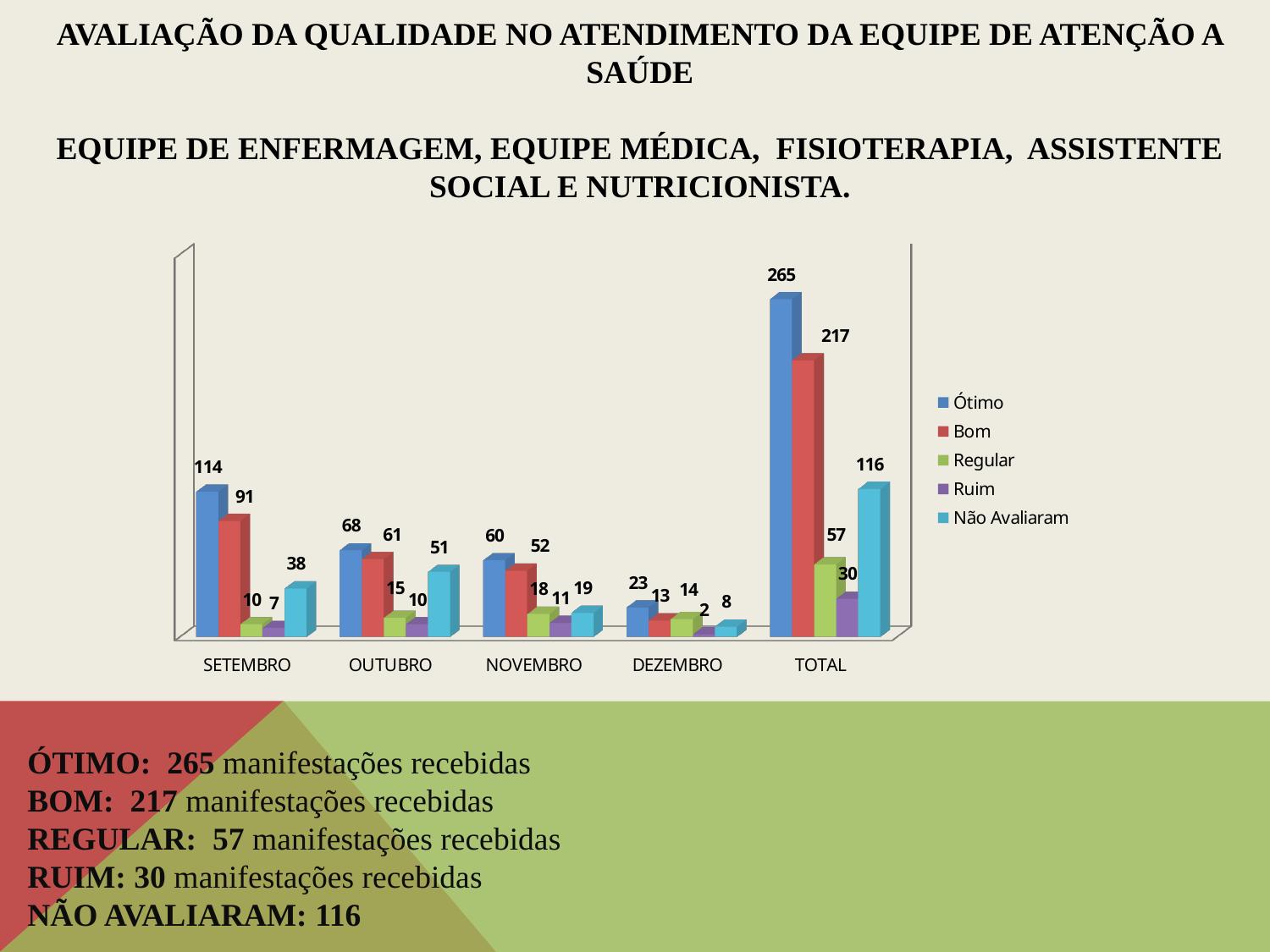
What is the difference between Ótimo and Bom in the TOTAL category? 48 What is the value for Ótimo in SETEMBRO? 114 How many series does the legend list? 5 What is the value for Ruim in DEZEMBRO? 2 What is the value for Regular in NOVEMBRO? 18 What kind of chart is shown on the slide? Bar chart What is the value for Não Avaliaram in OUTUBRO? 51 Do the values for Ótimo rise or fall from SETEMBRO to DEZEMBRO? Fall Which month has the highest value for Bom (excluding TOTAL)? SETEMBRO Which is larger in DEZEMBRO, Bom or Regular? Regular Which month has the lowest value for Ótimo (excluding TOTAL)? DEZEMBRO How many categories are shown on the x axis? 5